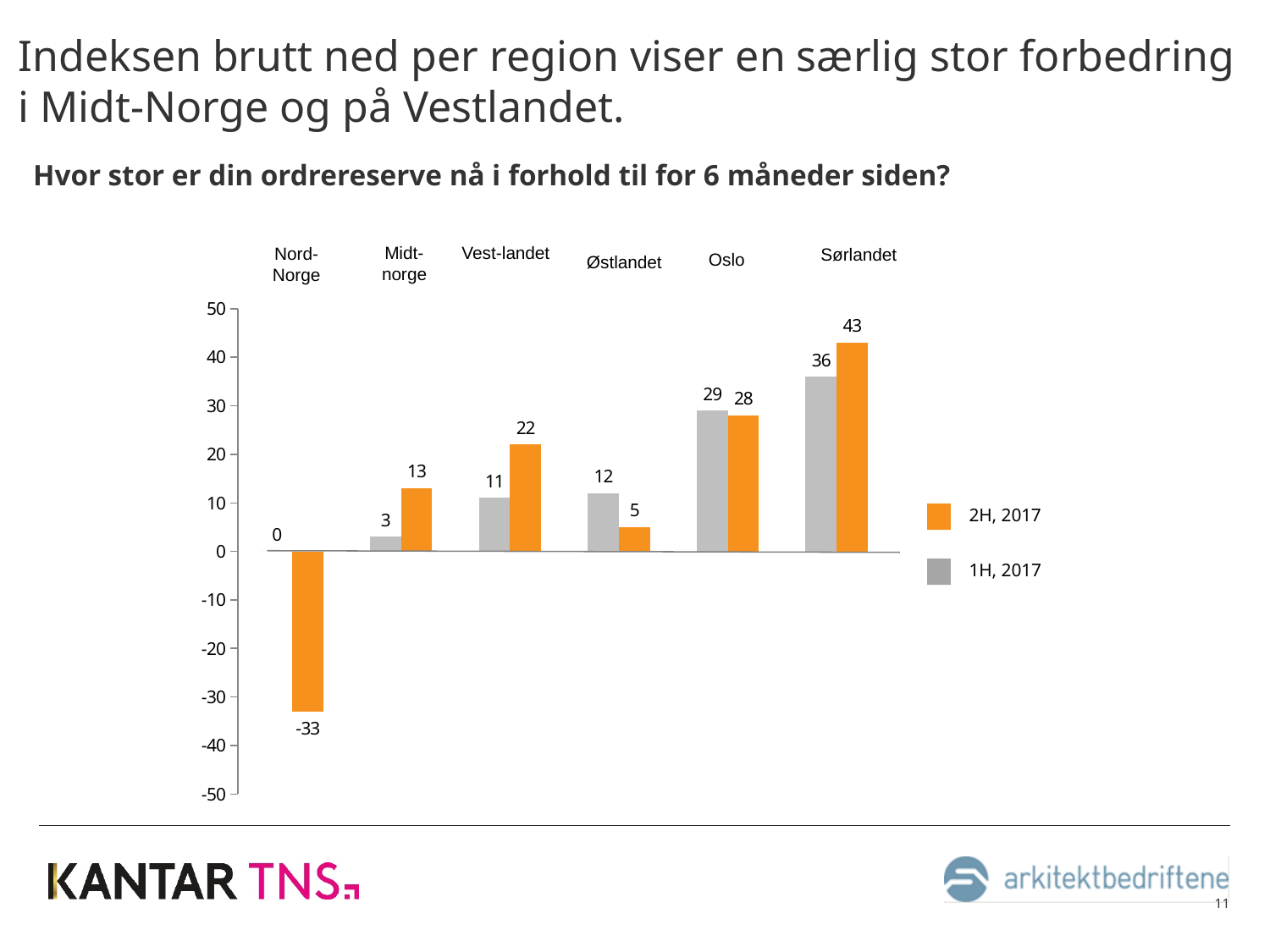
Which region has the highest value in the 2H, 2017 series? Sørlandet What kind of chart is shown on the slide? Bar chart What is the difference between the 2H, 2017 and 1H, 2017 values for Vest-landet? 11 Which region has the lowest value in the 2H, 2017 series? Nord-Norge What is the value for Midt-norge in the 1H, 2017 series? 3 How many regions are shown on the chart? 6 What is the value for Nord-Norge in the 2H, 2017 series? -33 What is the value for Sørlandet in the 2H, 2017 series? 43 Which colour represents the 2H, 2017 series? Orange For Østlandet, which is larger: the 1H, 2017 value or the 2H, 2017 value? 1H, 2017 What is the value for Østlandet in the 1H, 2017 series? 12 How many series does the legend list? 2